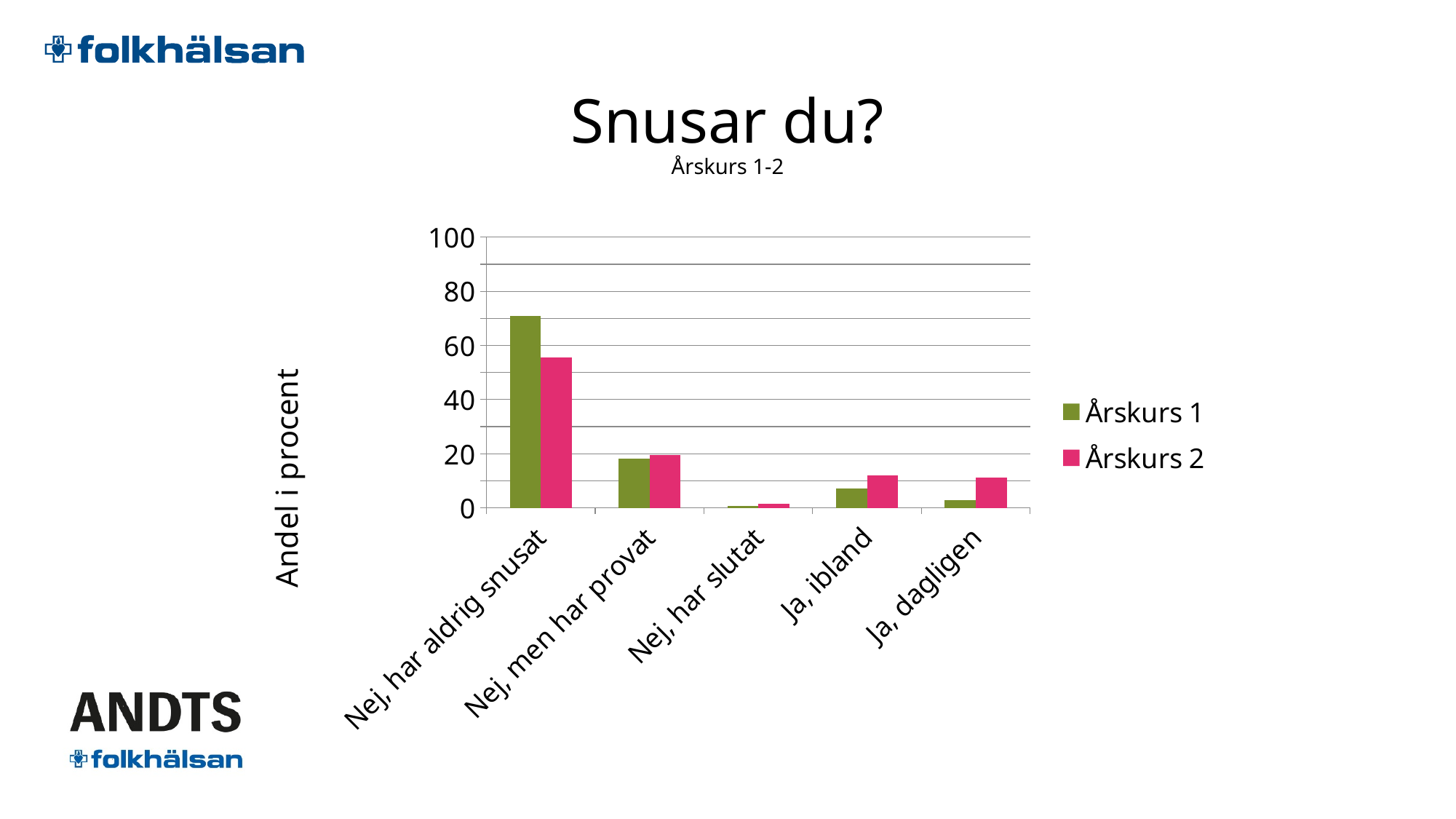
For 'Ja, dagligen', which series has the larger value, Årskurs 1 or Årskurs 2? Årskurs 2 Is the value for Årskurs 2 in 'Nej, har aldrig snusat' greater or less than 60? less What kind of chart is shown on the slide? bar chart How many categories are shown on the x axis? 5 Which category has the lowest value for Årskurs 1? Nej, har slutat How many series does the legend list? 2 Is the value for Årskurs 2 in 'Ja, ibland' greater or less than 20? less What is the label on the vertical axis? Andel i procent Which category has the highest value for Årskurs 1? Nej, har aldrig snusat What is the title of the chart? Snusar du? For 'Nej, har aldrig snusat', which series has the larger value, Årskurs 1 or Årskurs 2? Årskurs 1 Is the value for Årskurs 1 in 'Nej, har aldrig snusat' greater or less than 60? greater